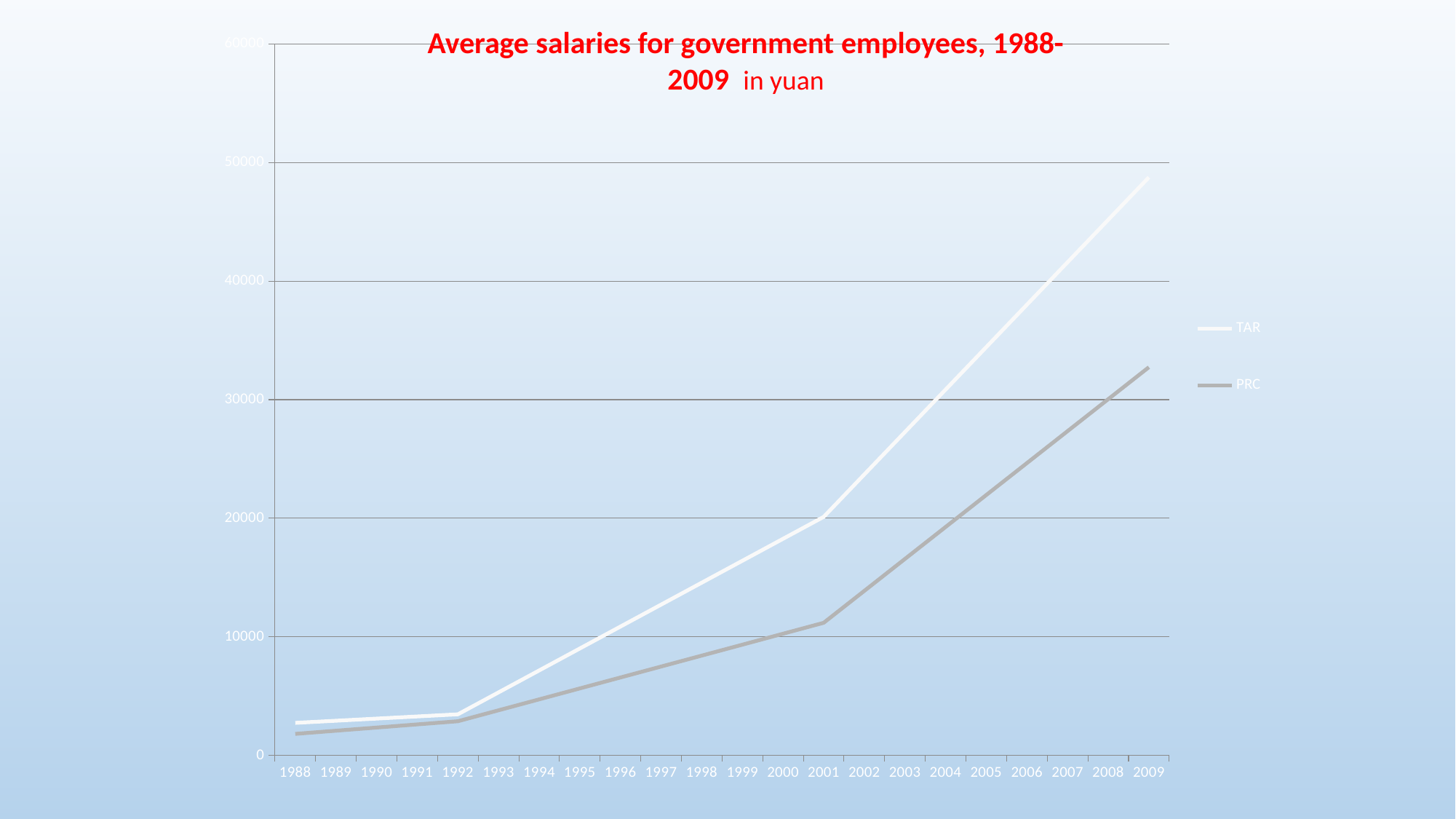
Is the PRC value for 2001 greater or less than 20000? less What is the title of the chart? Average salaries for government employees, 1988-2009 in yuan How many series does the legend list? 2 Do the TAR values rise or fall from 1988 to 2009? rise Do the PRC values rise or fall from 1988 to 2009? rise Is the TAR value for 2009 greater or less than 40000? greater Which two series are listed in the legend? TAR and PRC In 2009, which series has the larger value, TAR or PRC? TAR What kind of chart is shown on the slide? line chart Is the PRC value for 2009 greater or less than 30000? greater How many years are shown along the x axis? 22